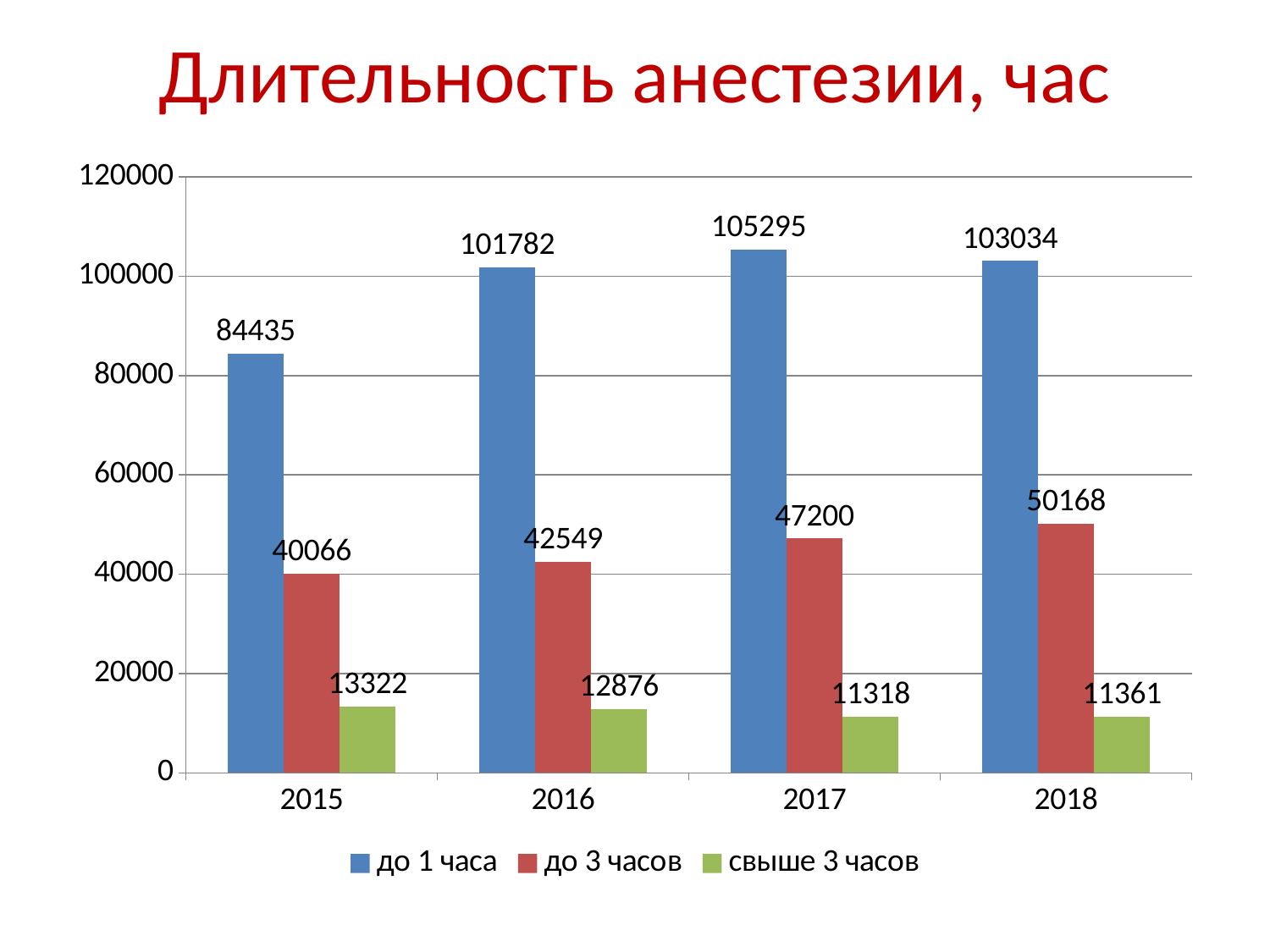
Which is larger: the "до 1 часа" value for 2016 or for 2018? 2018 Does the value for "до 3 часов" rise or fall from 2015 to 2018? rise What is the value for "до 1 часа" in 2017? 105295 What is the difference between the "до 3 часов" values for 2018 and 2017? 2968 In which year is the value for "свыше 3 часов" lowest? 2017 Is the value for "до 3 часов" in 2018 greater or less than 40000? greater What is the value for "свыше 3 часов" in 2016? 12876 How many series does the legend list? 3 What is the value for "до 3 часов" in 2015? 40066 What kind of chart is shown on the slide? bar chart How many years are shown on the x axis? 4 In which year is the value for "до 1 часа" highest? 2017